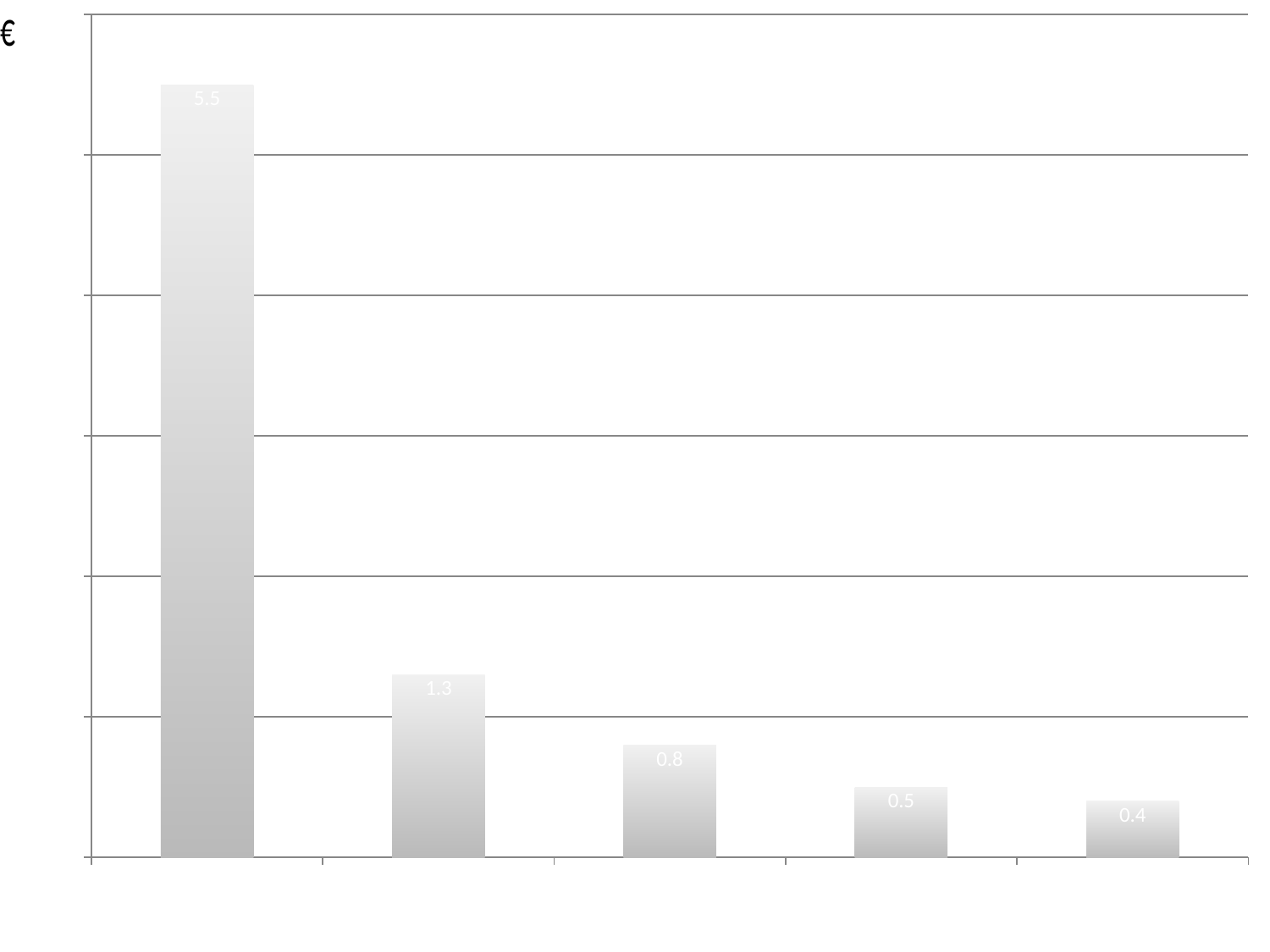
What kind of chart is shown on the slide? bar chart What is the value shown on the fourth bar from the left? 0.5 What is the value shown on the first (leftmost) bar? 5.5 Do the bar values rise or fall from left to right? fall What currency symbol is shown at the top left of the chart? € What is the difference between the first bar's value and the second bar's value? 4.2 Which bar has the lowest value? the last (rightmost) bar, 0.4 Which bar has the highest value? the first (leftmost) bar, 5.5 How many bars are plotted in the chart? 5 What is the value shown on the second bar from the left? 1.3 What is the value shown on the third bar from the left? 0.8 What is the value shown on the last (rightmost) bar? 0.4